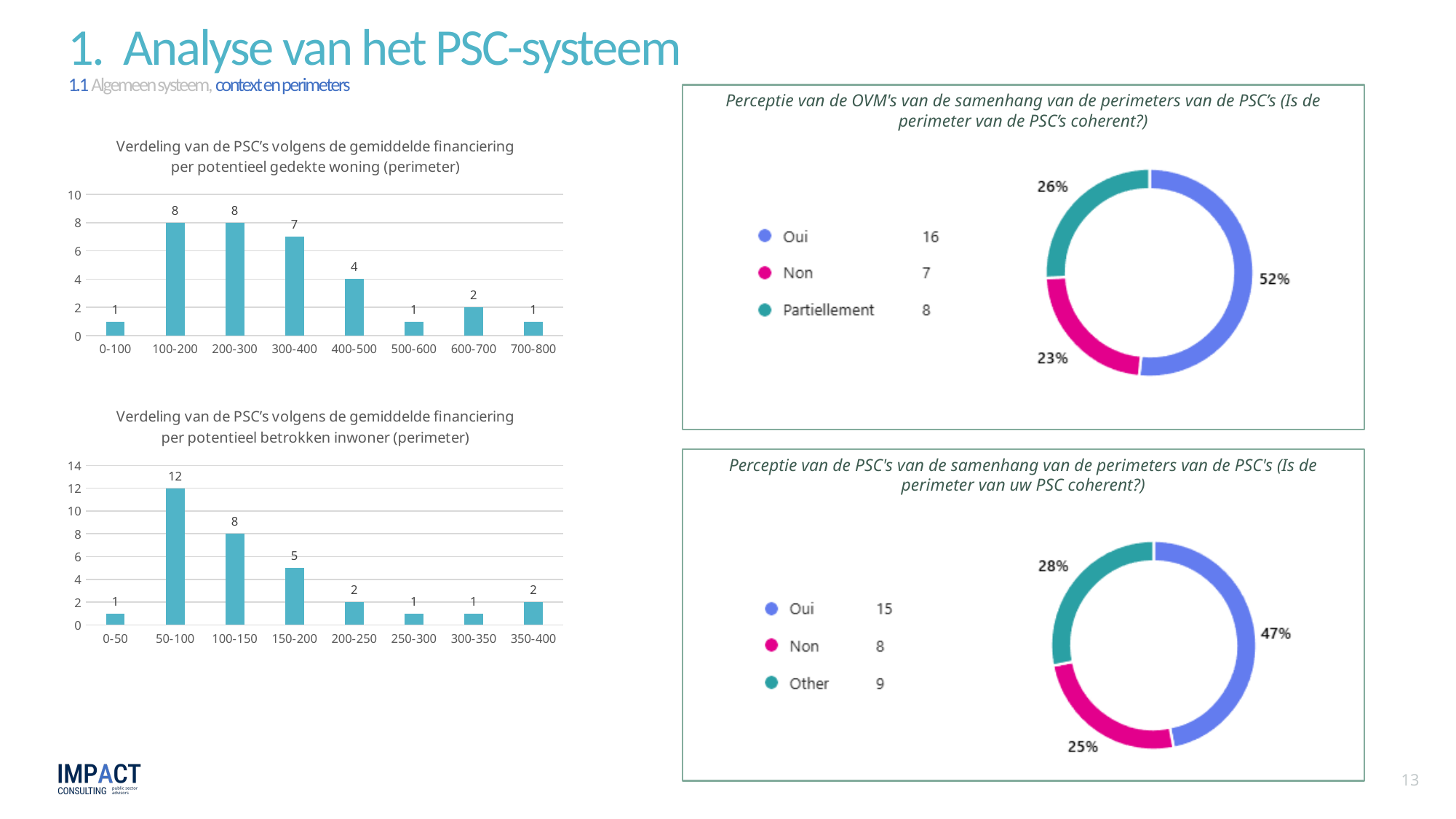
How many categories are shown on the x axis of the bar chart titled 'Verdeling van de PSC's volgens de gemiddelde financiering per potentieel gedekte woning (perimeter)'? 8 In the bar chart titled 'Verdeling van de PSC's volgens de gemiddelde financiering per potentieel betrokken inwoner (perimeter)', which category has the highest value? 50-100 How many entries does the legend list in the bottom-right chart titled 'Perceptie van de PSC's van de samenhang van de perimeters van de PSC's'? 3 In the bar chart titled 'Verdeling van de PSC's volgens de gemiddelde financiering per potentieel betrokken inwoner (perimeter)', what is the value for the 150-200 category? 5 In the top-right chart titled 'Perceptie van de OVM's van de samenhang van de perimeters van de PSC's', what is the count for 'Non'? 7 In the bottom-right chart titled 'Perceptie van de PSC's van de samenhang van de perimeters van de PSC's', what is the count for 'Other'? 9 What kind of chart is the top-left chart titled 'Verdeling van de PSC's volgens de gemiddelde financiering per potentieel gedekte woning (perimeter)'? bar chart In the bar chart titled 'Verdeling van de PSC's volgens de gemiddelde financiering per potentieel gedekte woning (perimeter)', what is the value for the 300-400 category? 7 In the top-right chart titled 'Perceptie van de OVM's van de samenhang van de perimeters van de PSC's', what share does 'Oui' represent? 52% In the bottom-right chart titled 'Perceptie van de PSC's van de samenhang van de perimeters van de PSC's', what share does 'Non' represent? 25% In the bar chart titled 'Verdeling van de PSC's volgens de gemiddelde financiering per potentieel betrokken inwoner (perimeter)', what is the difference between the values for 50-100 and 100-150? 4 In the bar chart titled 'Verdeling van de PSC's volgens de gemiddelde financiering per potentieel gedekte woning (perimeter)', which is larger: the value for 400-500 or the value for 600-700? 400-500